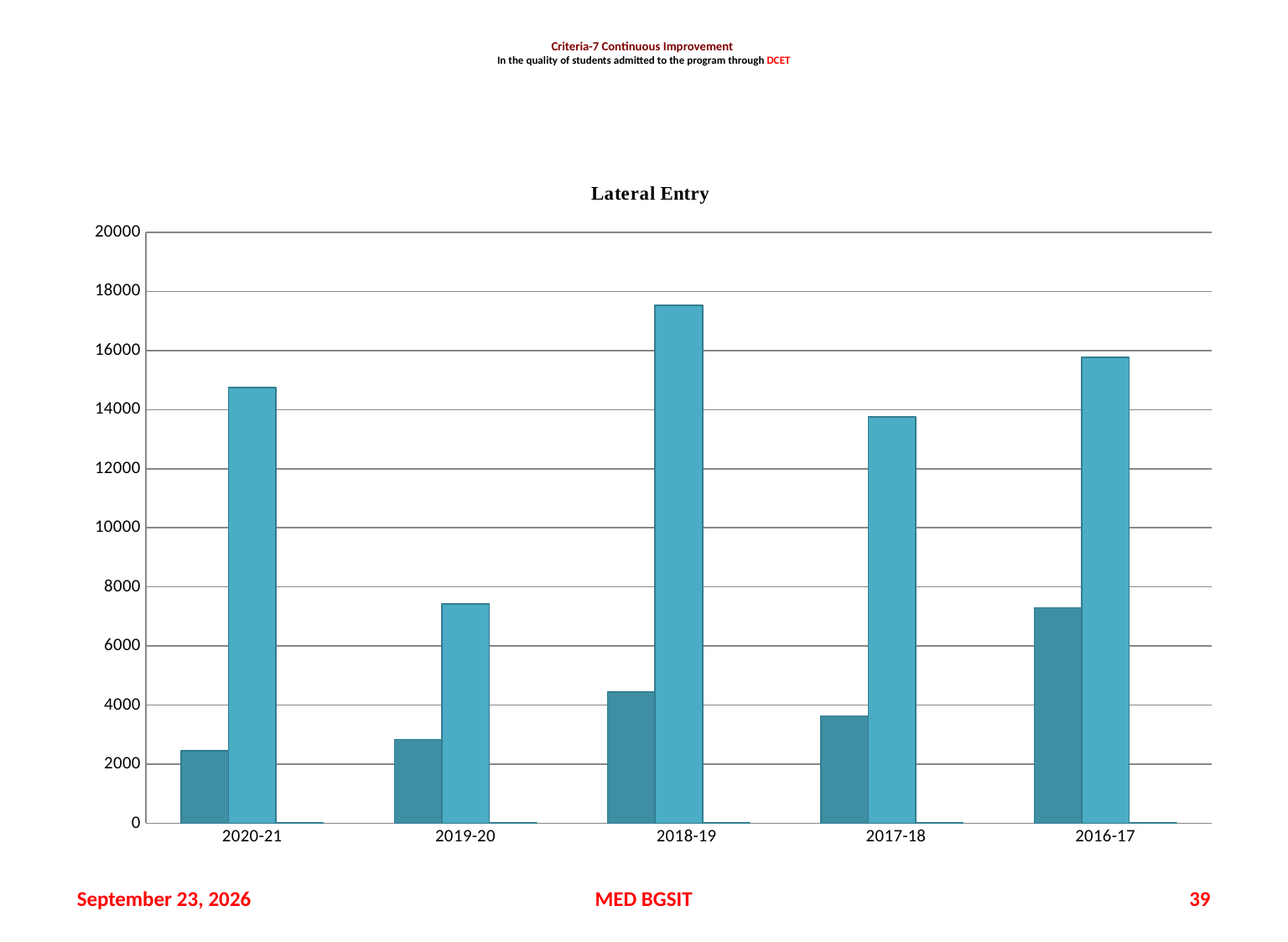
For which year is the lighter (taller) bar the lowest? 2019-20 Is the darker bar for 2020-21 greater or less than 4000? less For which year is the lighter (taller) bar the highest? 2018-19 Which year has the larger darker bar, 2018-19 or 2017-18? 2018-19 Is the lighter bar for 2019-20 greater or less than 8000? less What kind of chart is shown on the slide? bar chart How many academic-year categories are shown on the x axis? 5 For which year is the darker (shorter) bar the highest? 2016-17 What is the title of the chart? Lateral Entry Which year has the larger lighter bar, 2020-21 or 2017-18? 2020-21 Is the lighter bar for 2018-19 greater or less than 16000? greater